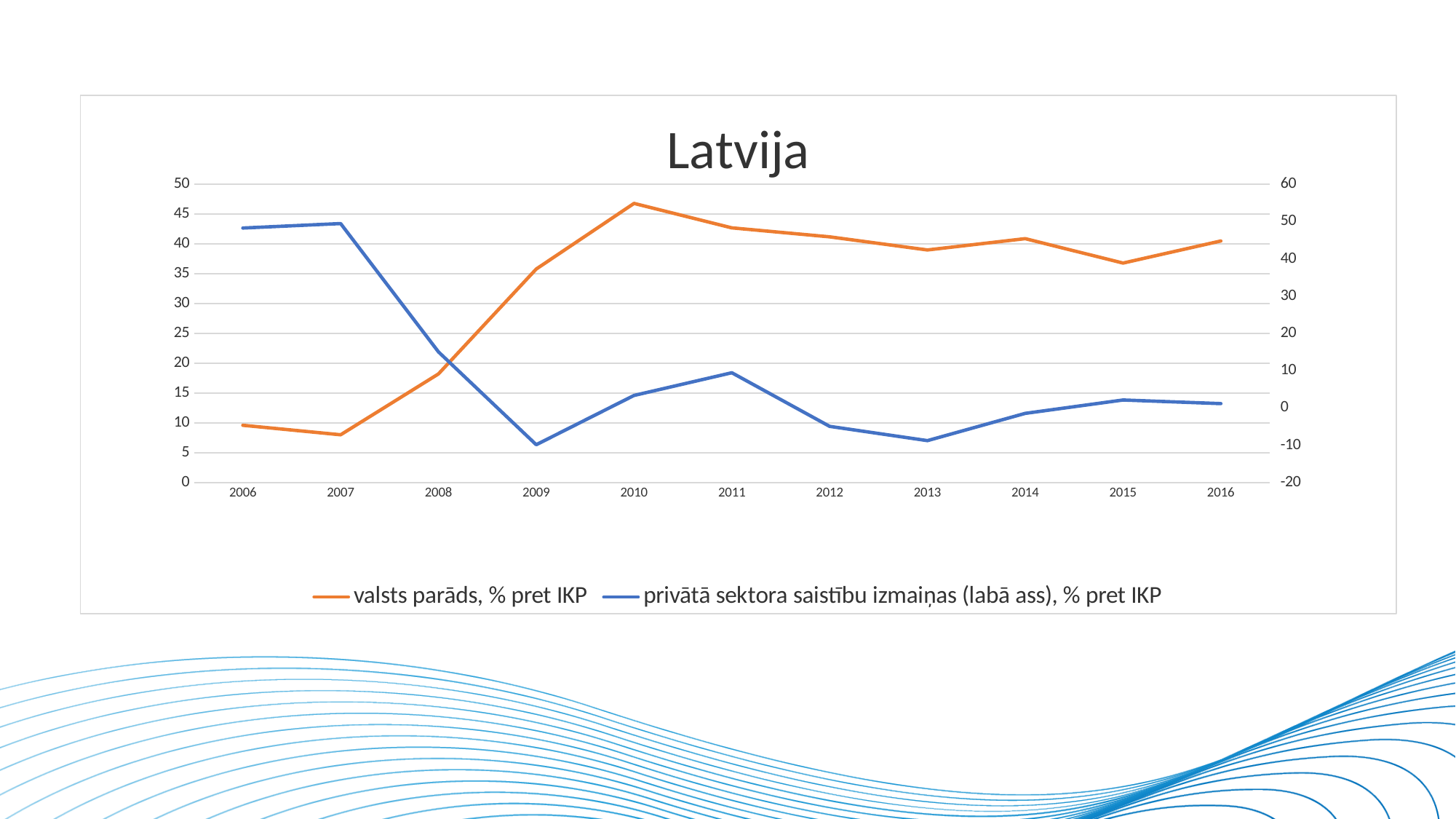
Is the value for 'privātā sektora saistību izmaiņas (labā ass), % pret IKP' in 2009 greater or less than 0 on the right axis? less How many years are shown on the x axis? 11 Which colour is used for the series 'privātā sektora saistību izmaiņas (labā ass), % pret IKP'? blue What is the title of the chart? Latvija How many series does the legend list? 2 Is the value for 'valsts parāds, % pret IKP' in 2010 greater or less than 45? greater Which is larger for 'privātā sektora saistību izmaiņas (labā ass), % pret IKP': the value in 2007 or the value in 2009? 2007 What kind of chart is shown on the slide? line chart Is the value for 'valsts parāds, % pret IKP' in 2015 greater or less than 40? less In which year does the series 'valsts parāds, % pret IKP' reach its highest value? 2010 In which year does the series 'valsts parāds, % pret IKP' have its lowest value? 2007 Does the series 'valsts parāds, % pret IKP' rise or fall between 2007 and 2010? rise